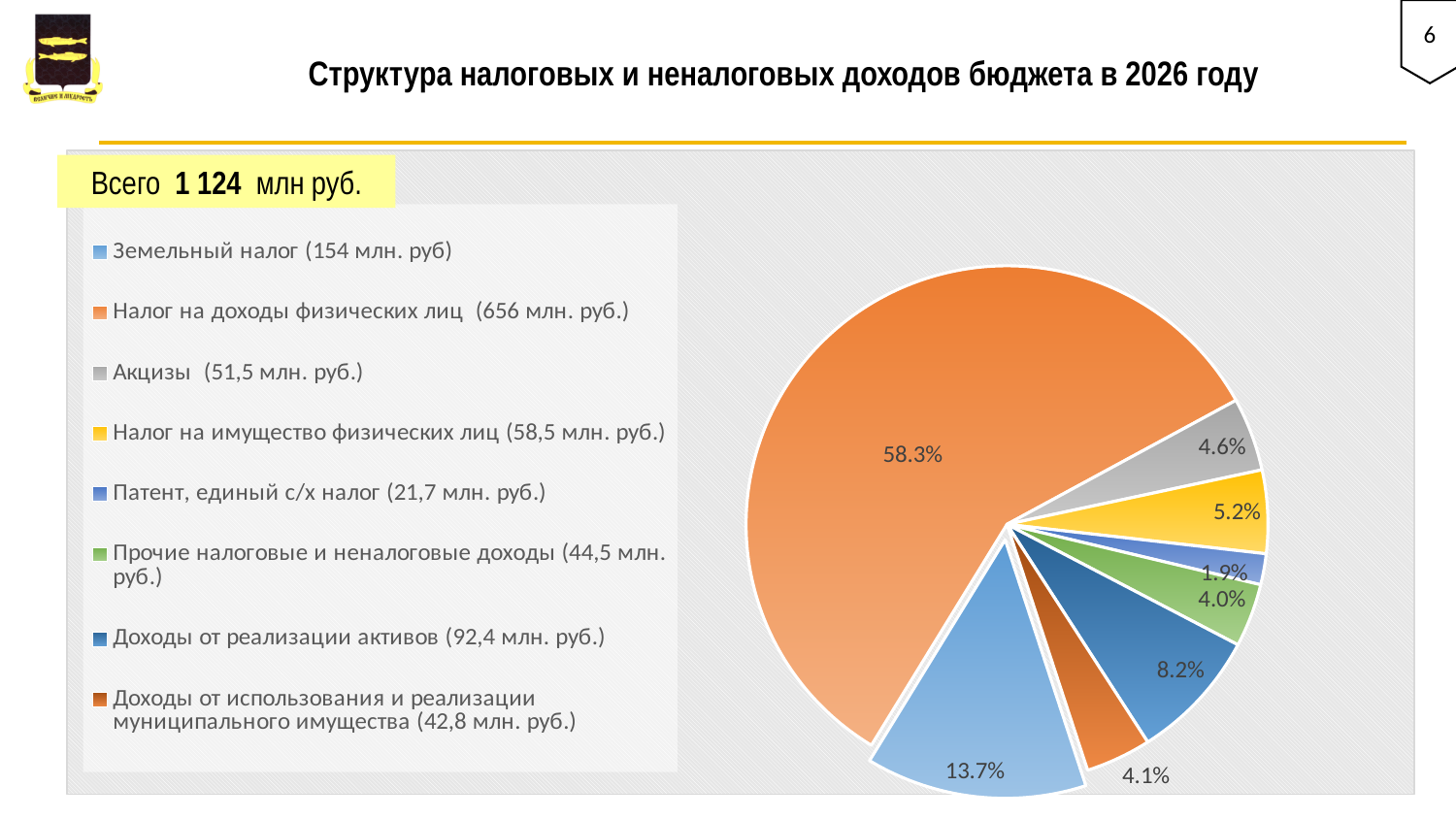
Which is larger: the share for "Налог на имущество физических лиц" or the share for "Акцизы"? Налог на имущество физических лиц What is the difference in percentage points between the share for "Земельный налог" and the share for "Доходы от реализации активов"? 5.5 What total amount is stated above the legend on the slide? 1 124 млн руб. What kind of chart is shown on the slide? pie chart Which category has the largest slice of the pie? Налог на доходы физических лиц What share of the pie does "Налог на доходы физических лиц" have? 58.3% How many slices does the pie chart have? 8 What share of the pie does "Земельный налог" have? 13.7% What value in млн. руб. does the legend give for "Акцизы"? 51,5 млн. руб. What share of the pie does "Доходы от реализации активов" have? 8.2% Which category has the smallest slice of the pie? Патент, единый с/х налог